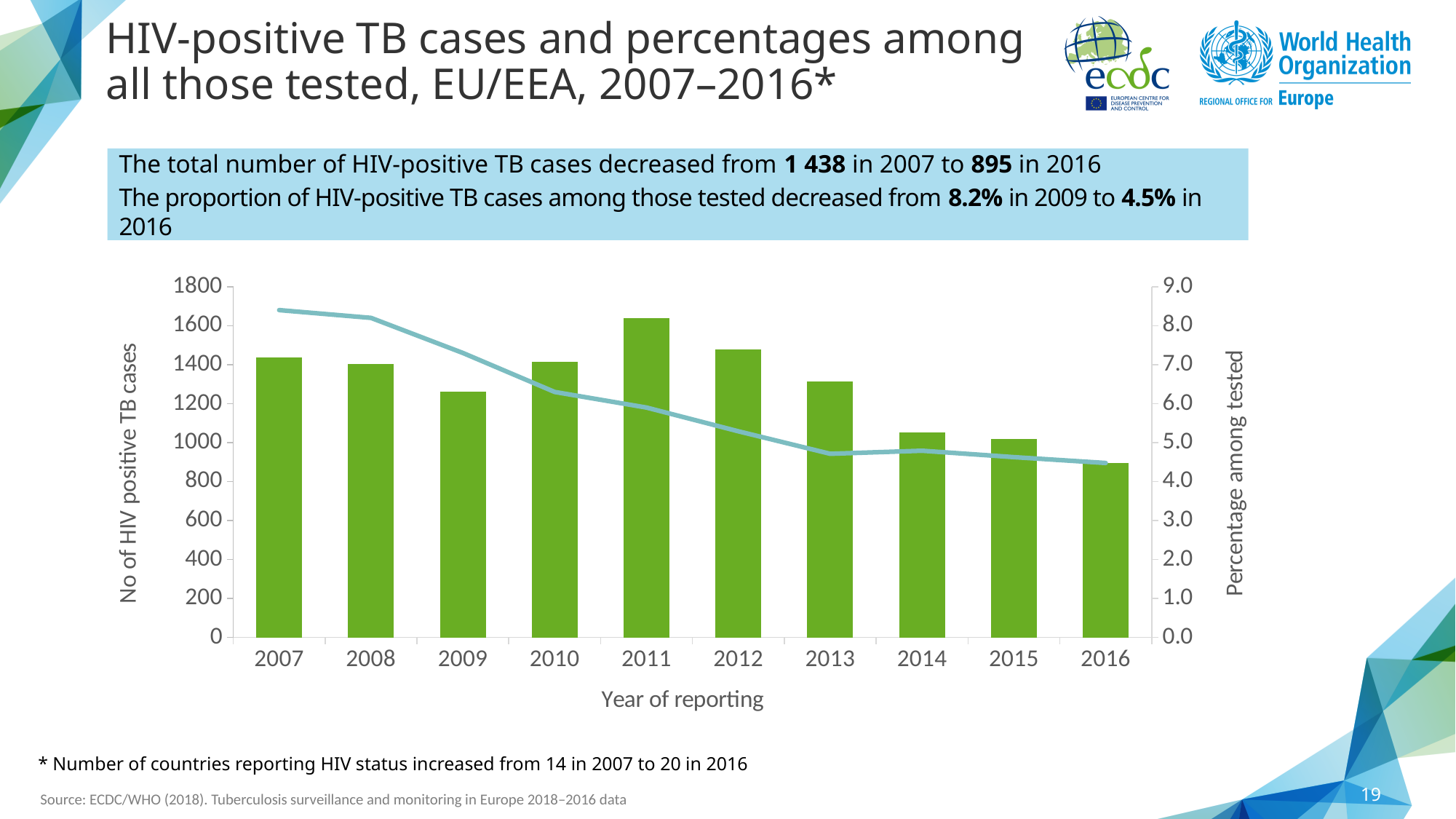
What was the total number of HIV-positive TB cases in 2016? 895 Which year has the lowest number of HIV positive TB cases (shortest bar)? 2016 Which year has more HIV positive TB cases, 2011 or 2012? 2011 Is the number of HIV positive TB cases in 2009 greater or less than 1400? less How many years of reporting are shown on the x axis of the chart? 10 What was the total number of HIV-positive TB cases in 2007? 1 438 Does the percentage among tested line rise or fall from 2007 to 2016? fall What was the proportion of HIV-positive TB cases among those tested in 2009? 8.2% What is the label of the left vertical axis of the chart? No of HIV positive TB cases What kind of chart is shown on the slide? bar chart with a line By how much did the number of HIV-positive TB cases decrease from 2007 to 2016? 543 Which year has the highest number of HIV positive TB cases (tallest bar)? 2011